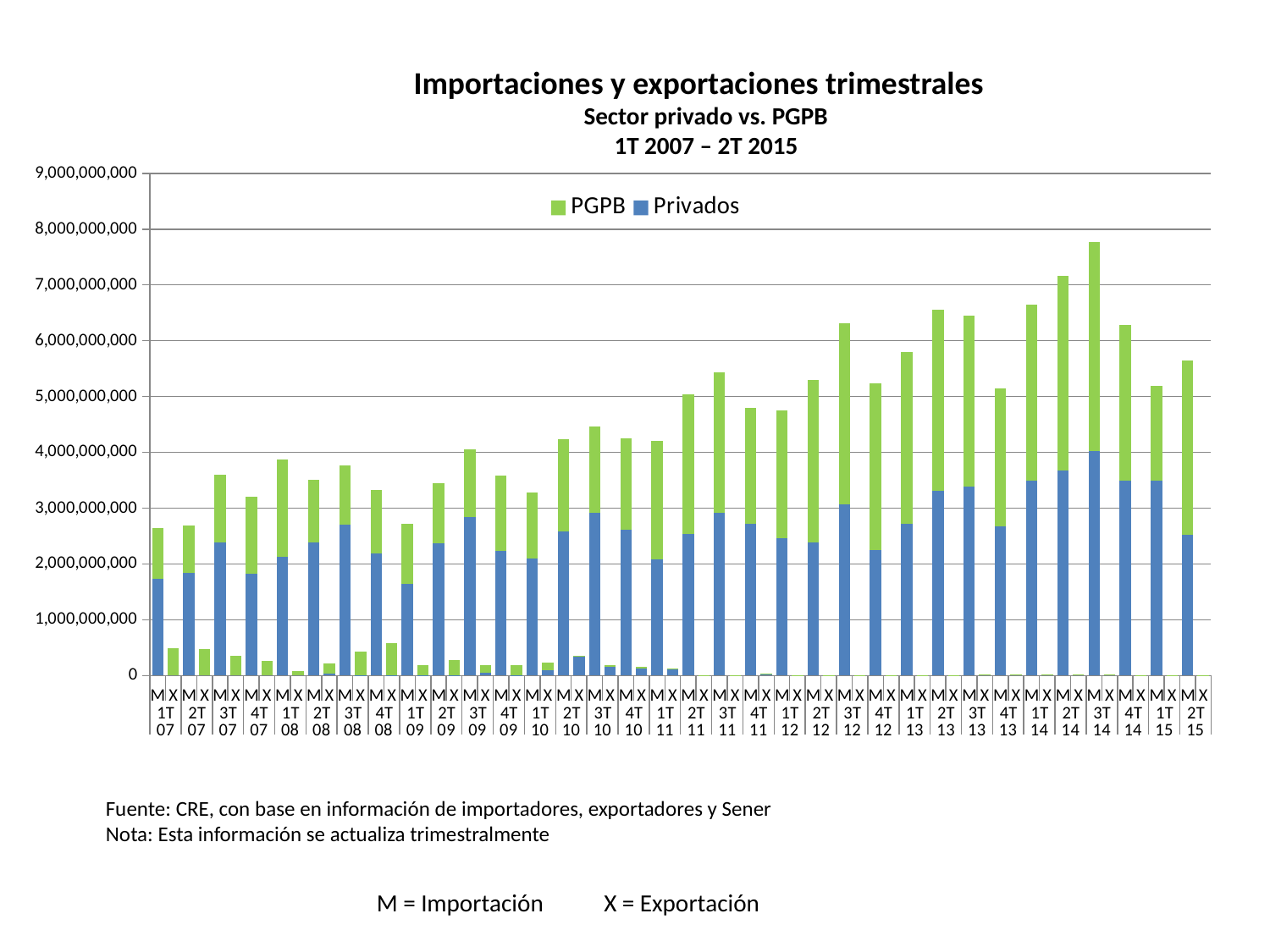
Is the total value of the M bar for 1T 09 greater or less than 3,000,000,000? less Is the total value of the M bar for 3T 14 greater or less than 7,000,000,000? greater Which is larger, the total of the M bar for 1T 07 or the M bar for 3T 07? M 3T 07 Is the total value of the M bar for 3T 12 greater or less than 6,000,000,000? greater Which series is shown in green in the legend? PGPB How many series does the legend list? 2 Which bar is the tallest in the chart? M 3T 14 According to the note below the chart, what does the label M stand for? Importación Which is larger, the total of the M bar for 1T 13 or the M bar for 4T 13? M 1T 13 Do the X (Exportación) bars generally rise or fall from 2007 to 2015? Fall What kind of chart is shown on the slide? Stacked bar chart